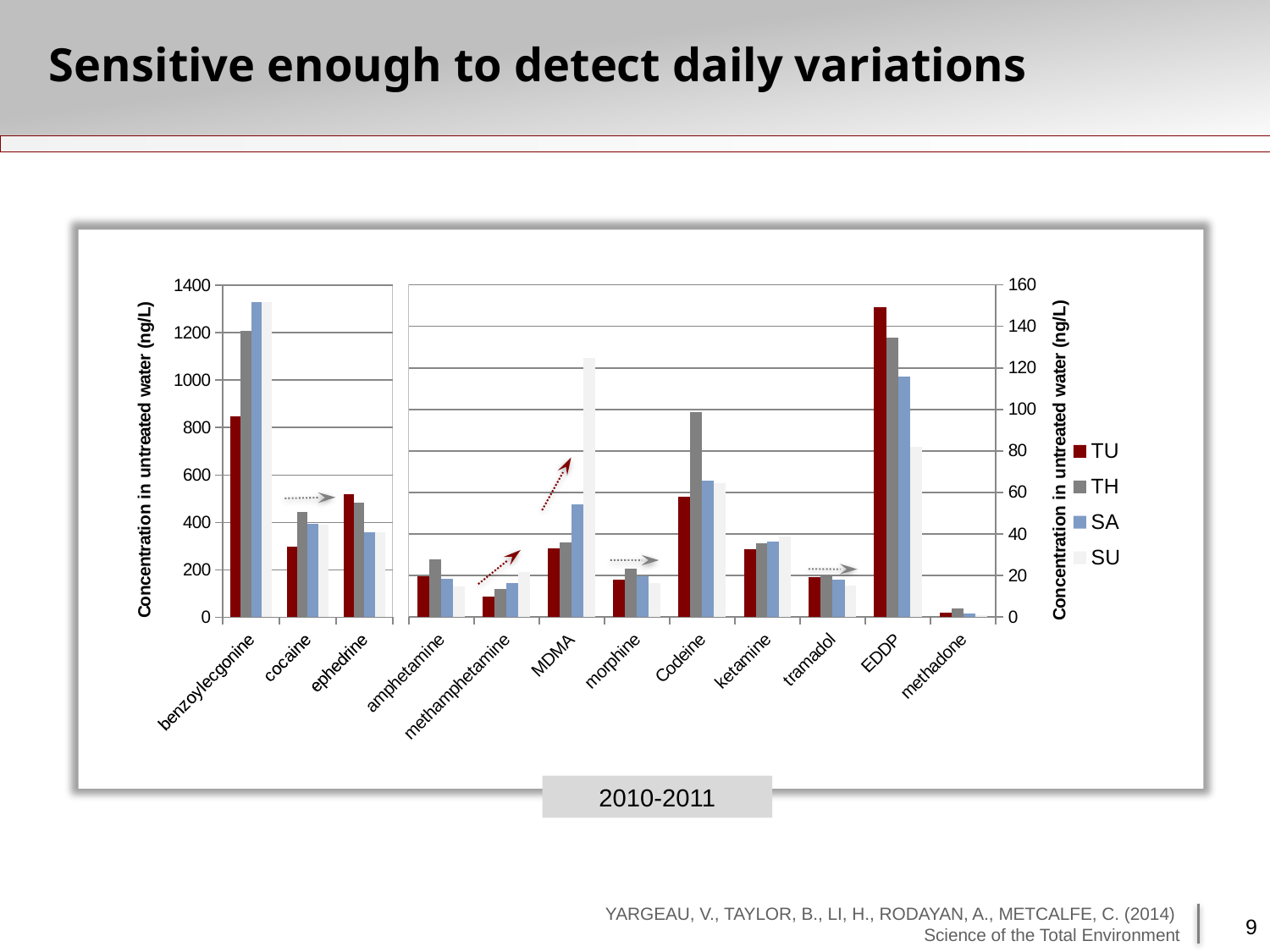
For benzoylecgonine, which is larger, the TU value or the TH value? TH Which series has the highest value for MDMA? SU What kind of chart is shown on the slide? bar chart Which series has the highest value for ephedrine? TU Is the TU value for cocaine greater or less than 400 on the left axis? less Which series has the highest value for cocaine? TH What are the four series names listed in the legend? TU, TH, SA, SU How many compound categories are shown along the x axis? 12 How many series does the legend list? 4 Is the SU value for benzoylecgonine greater or less than 1200 on the left axis? greater